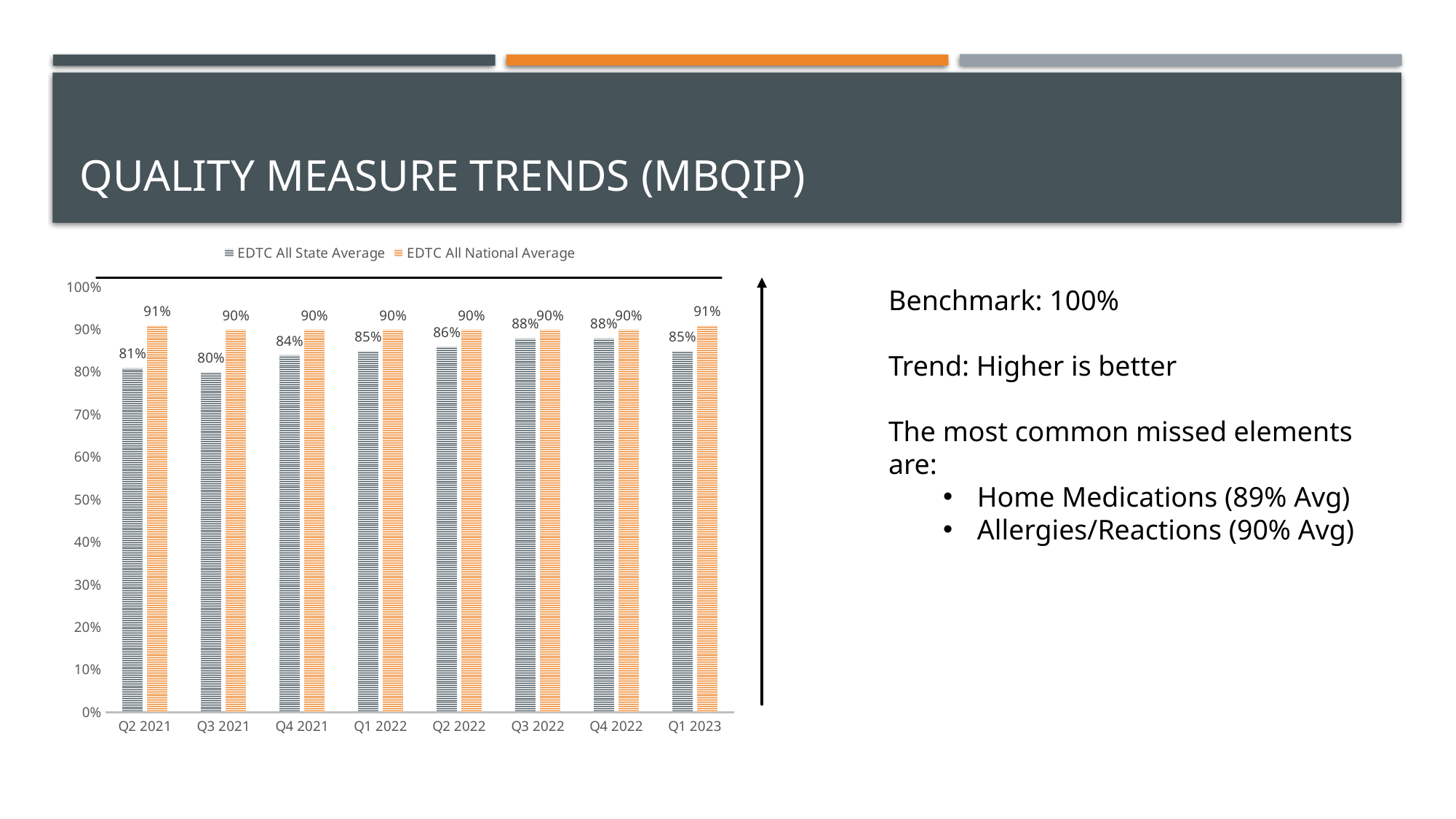
What kind of chart is shown on the slide? Bar chart Which quarter has the lowest EDTC All State Average? Q3 2021 What is the EDTC All National Average for Q1 2023? 91% Is the EDTC All State Average for Q2 2022 greater or less than 80%? greater What is the difference between the EDTC All National Average and the EDTC All State Average in Q3 2021? 10% What is the EDTC All State Average for Q2 2021? 81% What colour represents the EDTC All National Average series in the chart? Orange How many quarters are shown on the x axis of the chart? 8 Does the EDTC All State Average rise or fall from Q3 2021 to Q4 2022? Rise What is the EDTC All State Average for Q4 2022? 88% Which is larger in Q1 2022, the EDTC All State Average or the EDTC All National Average? EDTC All National Average How many series does the chart legend list? 2